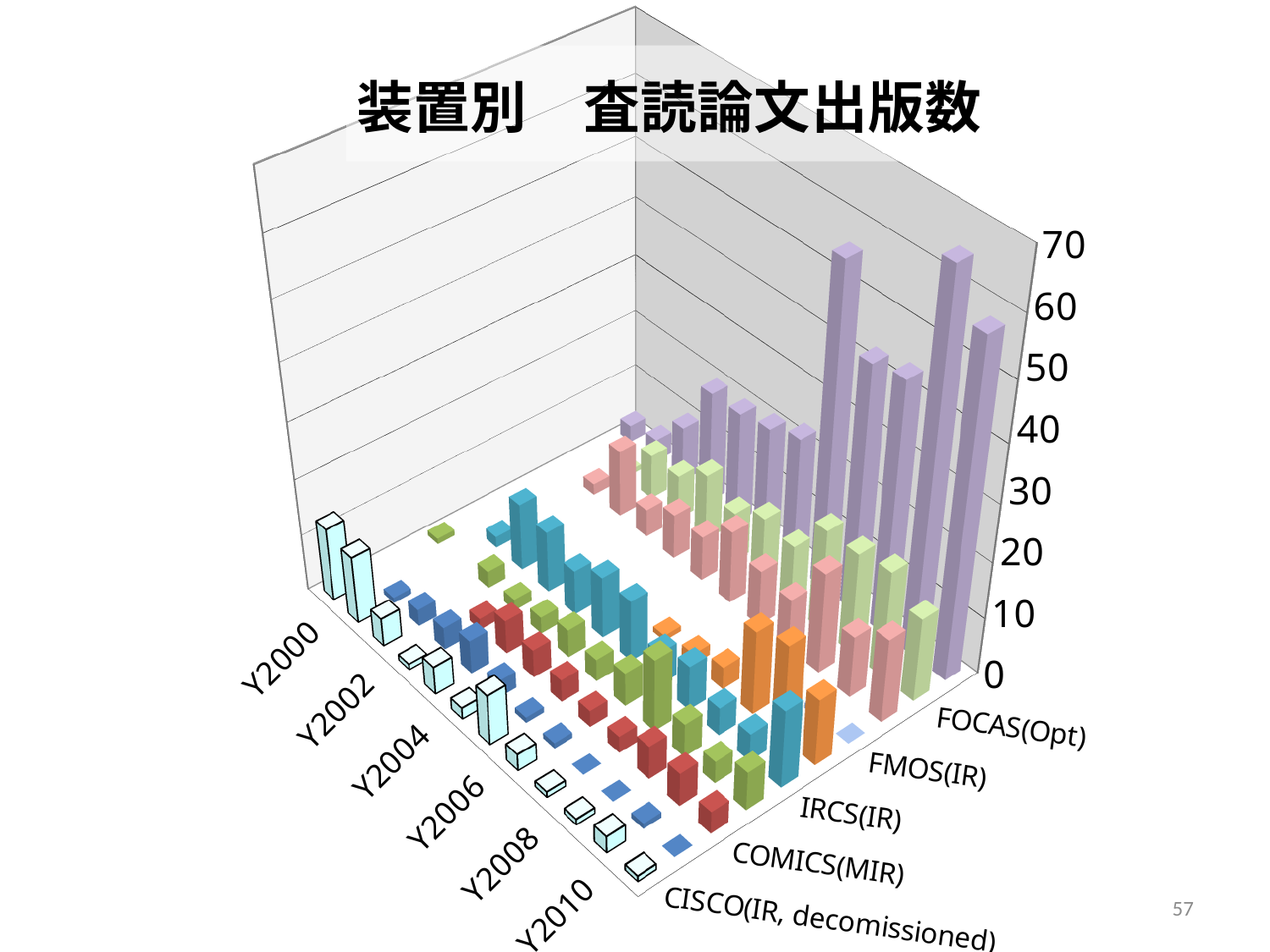
Do the bars for CISCO(IR, decomissioned) rise or fall from Y2000 to Y2010? fall What is the last year label shown on the chart's year axis? Y2010 What kind of chart is shown on the slide? 3D bar chart Which instrument label is closest to the front of the chart? CISCO(IR, decomissioned) What is the title of the chart? 装置別 査読論文出版数 What is the highest value shown on the vertical axis of the chart? 70 What is the interval between the tick marks on the vertical axis? 10 Which instrument label appears directly behind COMICS(MIR) on the chart? IRCS(IR) What is the first year label shown on the chart's year axis? Y2000 How many year labels are printed along the year axis of the chart? 6